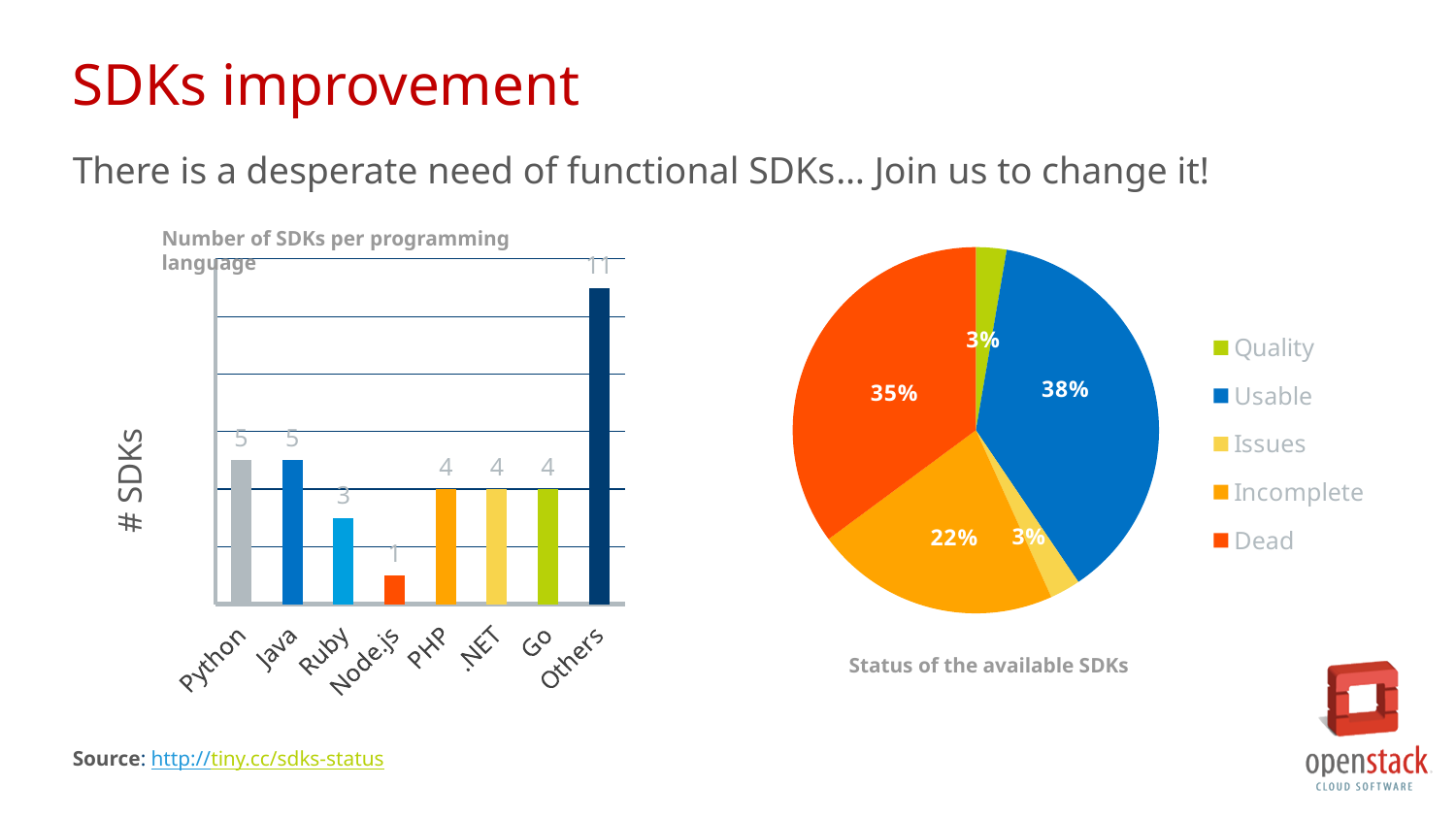
In the 'Status of the available SDKs' pie chart, what percentage of SDKs are Dead? 35% In the 'Number of SDKs per programming language' chart, how many SDKs are there for Node.js? 1 In the 'Number of SDKs per programming language' chart, what is the difference between the number of SDKs for Others and for Python? 6 In the 'Status of the available SDKs' pie chart, which status has the largest share? Usable In the 'Number of SDKs per programming language' chart, which has more SDKs, Java or PHP? Java In the 'Status of the available SDKs' pie chart, what percentage of SDKs are Usable? 38% How many entries does the legend of the 'Status of the available SDKs' pie chart list? 5 In the 'Number of SDKs per programming language' chart, which language has the lowest number of SDKs? Node.js In the 'Number of SDKs per programming language' chart, how many SDKs are there for Ruby? 3 What type of chart is the 'Number of SDKs per programming language' chart? Bar chart How many programming language categories are shown in the 'Number of SDKs per programming language' chart? 8 In the 'Number of SDKs per programming language' chart, which category has the highest number of SDKs? Others